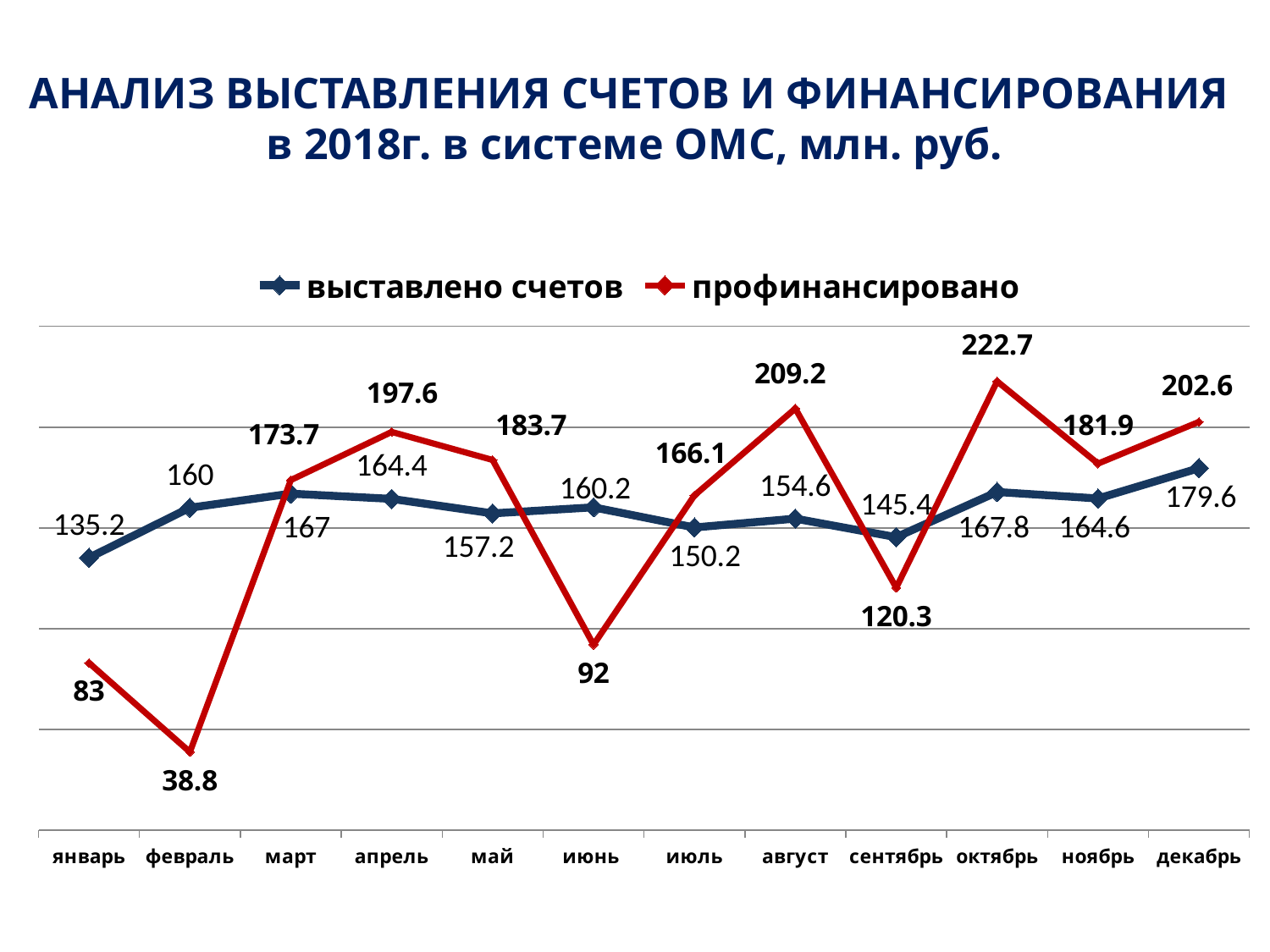
What is the value of 'профинансировано' for август? 209.2 Does 'профинансировано' rise or fall from сентябрь to октябрь? rise What is the value of 'профинансировано' for февраль? 38.8 How many series does the legend list? 2 What is the value of 'выставлено счетов' for январь? 135.2 Which is larger in июнь: 'выставлено счетов' or 'профинансировано'? выставлено счетов In which month is 'профинансировано' lowest? февраль How many months are plotted along the x axis? 12 What is the difference between 'профинансировано' and 'выставлено счетов' in октябрь? 54.9 In which month is 'выставлено счетов' highest? декабрь What type of chart is shown on the slide? line chart In which month is 'профинансировано' highest? октябрь